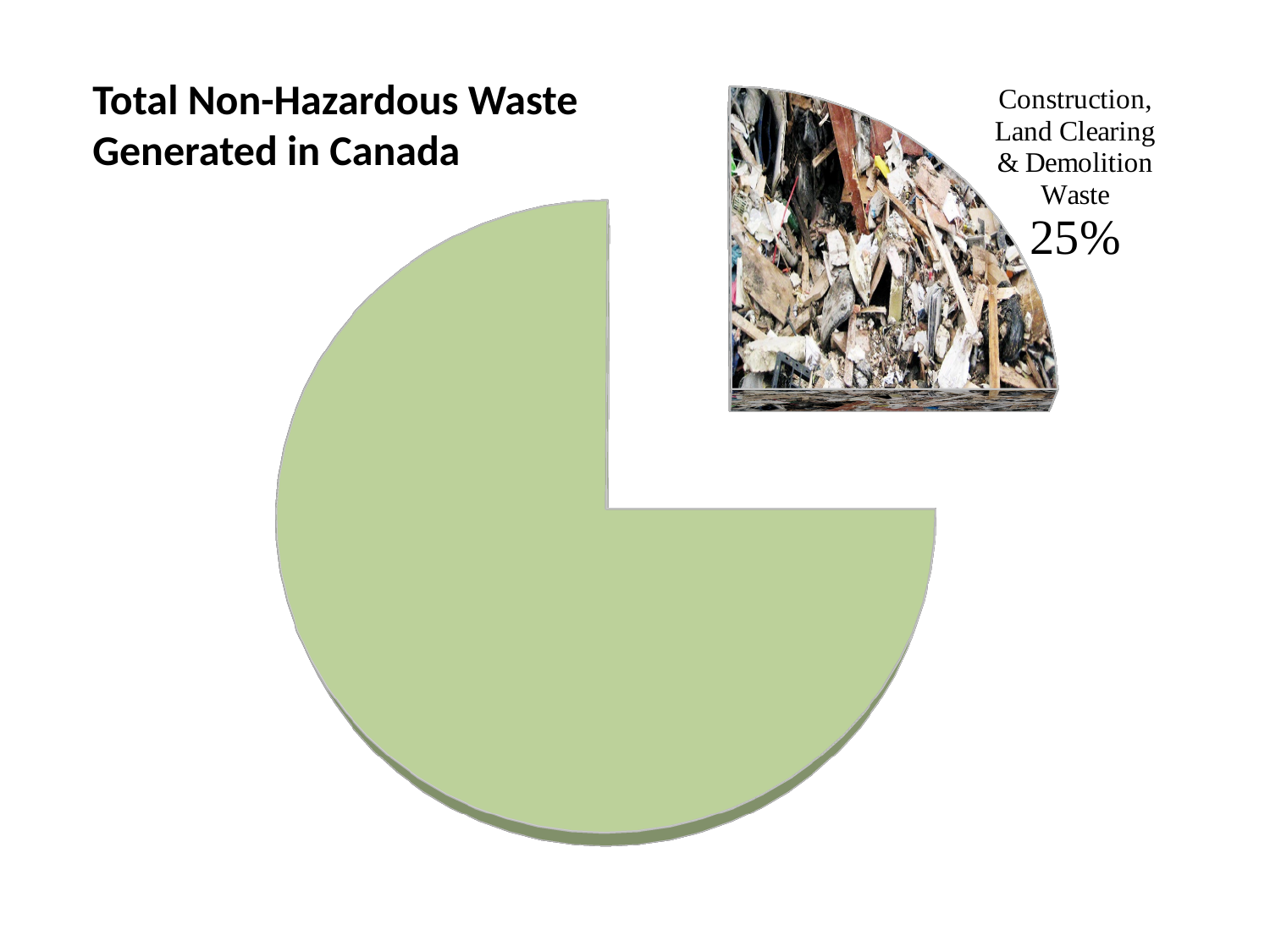
Which slice is larger: the Construction, Land Clearing & Demolition Waste slice or the green slice? The green slice What share of the pie is taken up by the green slice (the remainder after Construction, Land Clearing & Demolition Waste)? 75% How many slices does the pie chart have? 2 How is the Construction, Land Clearing & Demolition Waste slice filled? With a photograph of construction debris Is the share for Construction, Land Clearing & Demolition Waste greater or less than 50%? less What kind of chart is shown on the slide? Pie chart What is the title of the chart? Total Non-Hazardous Waste Generated in Canada What share of the pie is Construction, Land Clearing & Demolition Waste? 25% Which slice of the pie is the smallest? Construction, Land Clearing & Demolition Waste